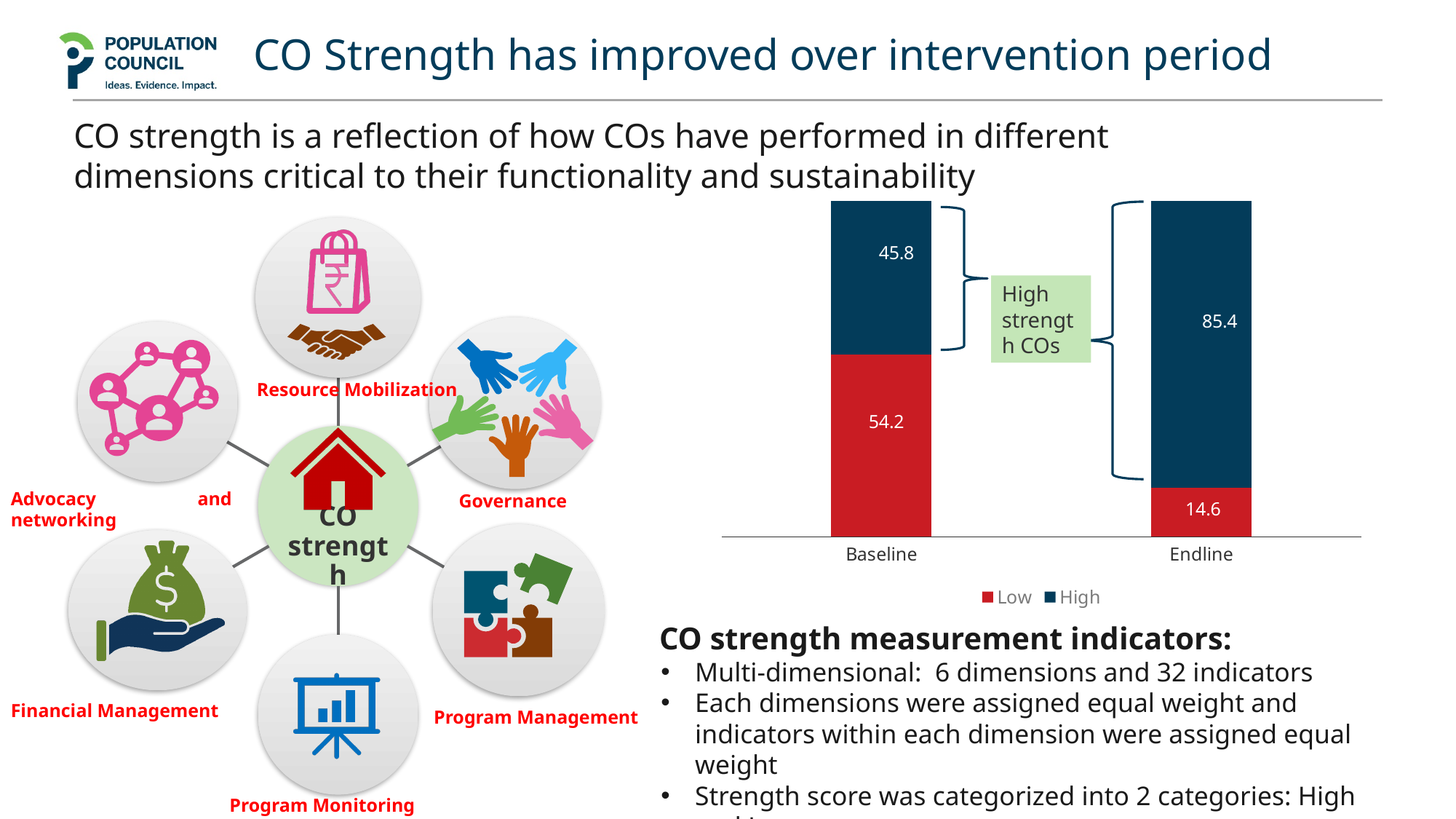
What is the value for High at Endline? 85.4 What is the difference between the High value at Endline and the High value at Baseline? 39.6 What is the value for Low at Baseline? 54.2 What is the total of the stacked bar for Baseline? 100 Which category has the lowest value for Low? Endline How many series does the chart legend list? 2 What is the value for Low at Endline? 14.6 What is the value for High at Baseline? 45.8 Which category has the higher value for High, Baseline or Endline? Endline What kind of chart is shown on the slide? Stacked bar chart Does the High value rise or fall from Baseline to Endline? Rise How many categories are shown on the x axis of the chart? 2